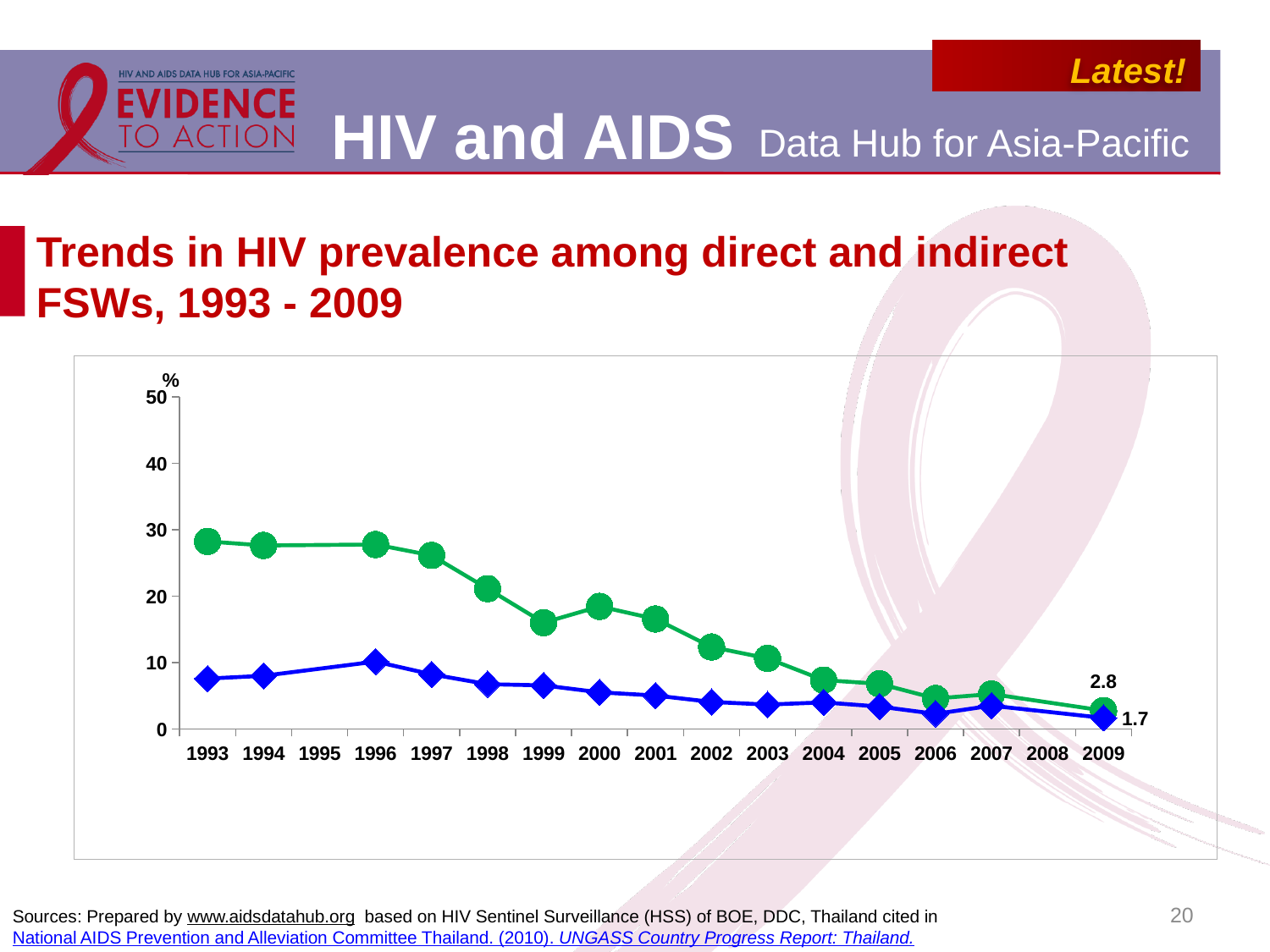
Is the value of the green line in 1993 greater or less than 20? greater In which year does the blue line reach its highest value? 1996 Is the value of the green line in 2004 greater or less than 10? less How many year labels are shown on the x axis? 17 What is the value of the blue line (diamond markers) in 2009? 1.7 What unit is shown at the top of the y axis? % Is the value of the blue line in 1996 greater or less than 20? less What is the value of the green line (circle markers) in 2009? 2.8 Does the green line generally rise or fall from 1993 to 2009? fall What kind of chart is shown on the slide? line chart In 2009, which line has the higher value, the green line or the blue line? green line What is the difference between the green line and the blue line values in 2009? 1.1